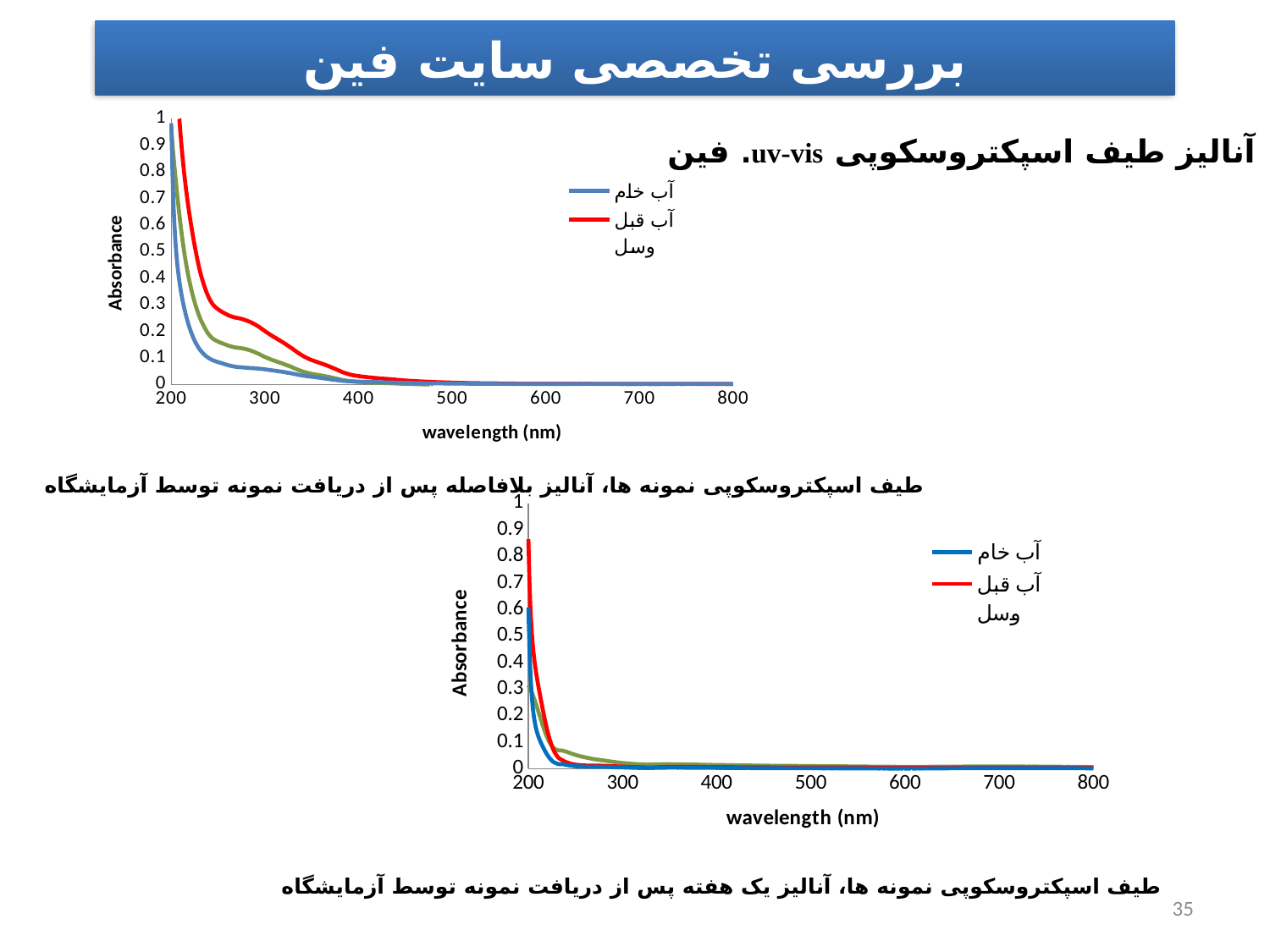
In the top chart, how many series does the legend list? 2 In the top chart, is the absorbance of the red line (آب قبل وسل) at 300 nm greater or less than 0.4? less In the bottom chart, is the absorbance of the red line (آب قبل وسل) at 200 nm greater or less than 0.7? greater In the bottom chart, what colour is the line for آب خام in the legend? blue What kind of chart is the top chart on the slide? line chart In the top chart, is the absorbance of the blue line (آب خام) at 200 nm greater or less than 0.9? greater In the top chart, at 300 nm, which series has the higher absorbance, آب خام or آب قبل وسل? آب قبل وسل What is the x-axis title of the top chart? wavelength (nm) What kind of chart is the bottom chart on the slide? line chart In the bottom chart, do the absorbance values rise or fall as wavelength increases from 200 nm to 800 nm? fall In the bottom chart, how many series does the legend list? 2 In the top chart, do the absorbance values rise or fall as wavelength increases from 200 nm to 800 nm? fall